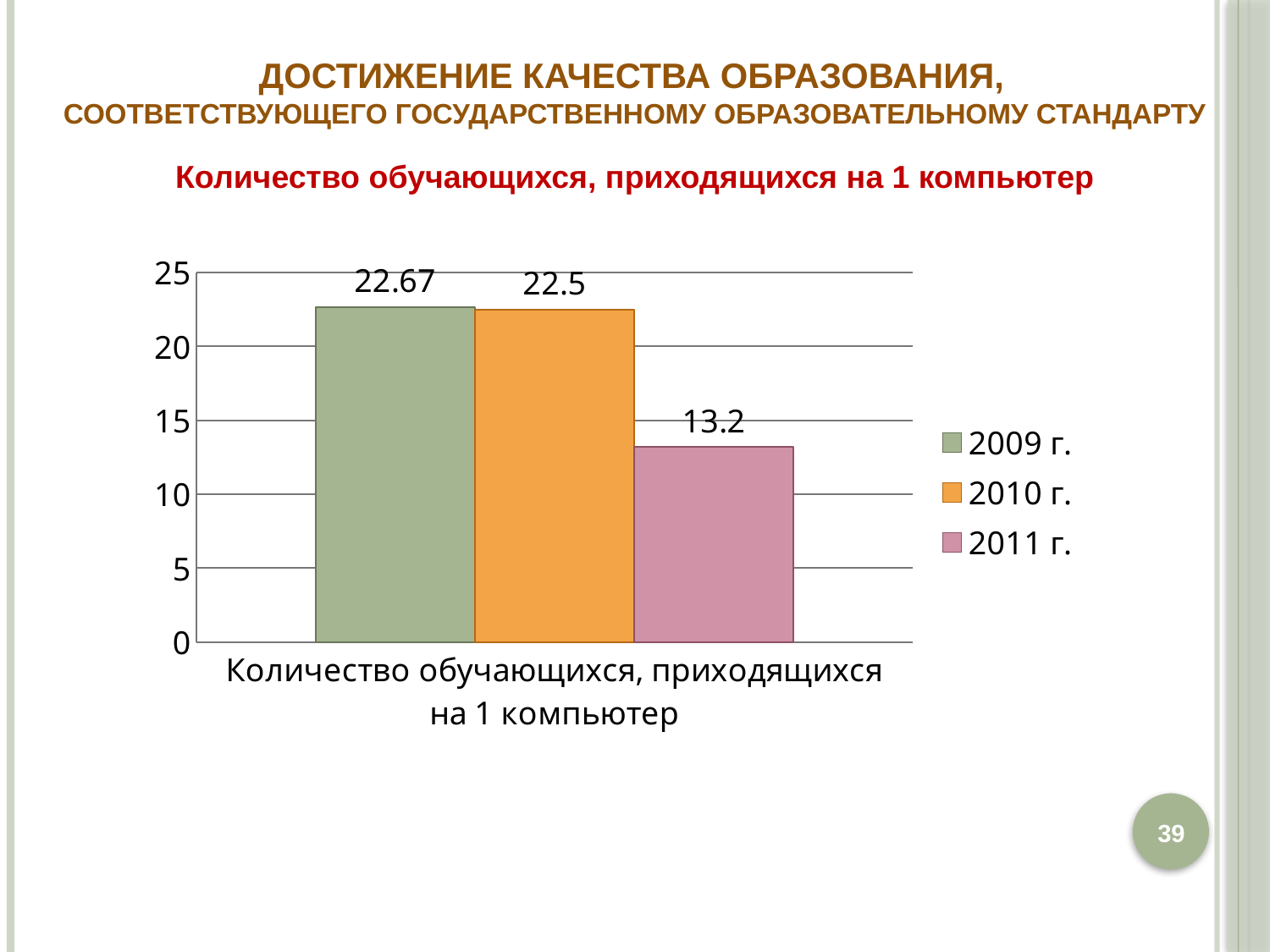
What is the value for 2010 г.? 22.5 How many series does the legend list? 3 Which year has the lowest value? 2011 г. What is the value for 2009 г.? 22.67 Which is larger, the value for 2010 г. or the value for 2011 г.? 2010 г. What is the difference between the values for 2010 г. and 2011 г.? 9.3 What is the difference between the values for 2009 г. and 2010 г.? 0.17 Which year has the highest value? 2009 г. Is the value for 2011 г. greater or less than 15? less What is the value for 2011 г.? 13.2 What colour is the bar for 2011 г.? pink What kind of chart is shown on the slide? bar chart